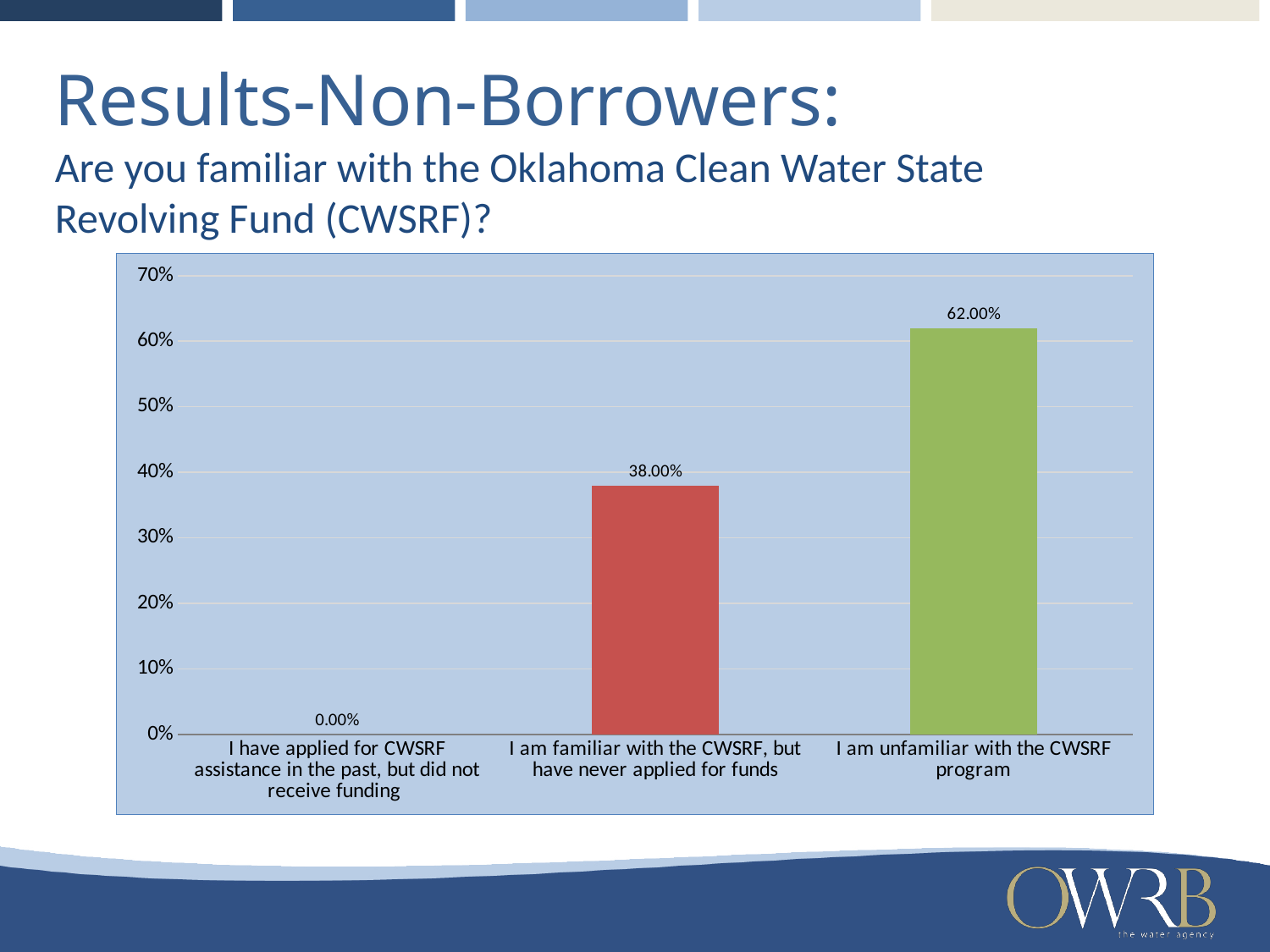
How many response categories are shown on the chart? 3 Is the value for 'I am familiar with the CWSRF, but have never applied for funds' greater or less than 40%? less What kind of chart is shown on the slide? Bar chart What percentage of non-borrowers said they are unfamiliar with the CWSRF program? 62.00% Which response category has the highest percentage? I am unfamiliar with the CWSRF program What is the difference in percentage points between those unfamiliar with the CWSRF program and those familiar but who never applied? 24.00% Which response category has the lowest percentage? I have applied for CWSRF assistance in the past, but did not receive funding What is the highest value shown on the vertical axis? 70% Which is larger: the percentage familiar with the CWSRF but never applied, or the percentage unfamiliar with the CWSRF program? I am unfamiliar with the CWSRF program What percentage of non-borrowers said they applied for CWSRF assistance in the past but did not receive funding? 0.00% Is the value for 'I am unfamiliar with the CWSRF program' greater or less than 60%? greater What percentage of non-borrowers said they are familiar with the CWSRF but have never applied for funds? 38.00%